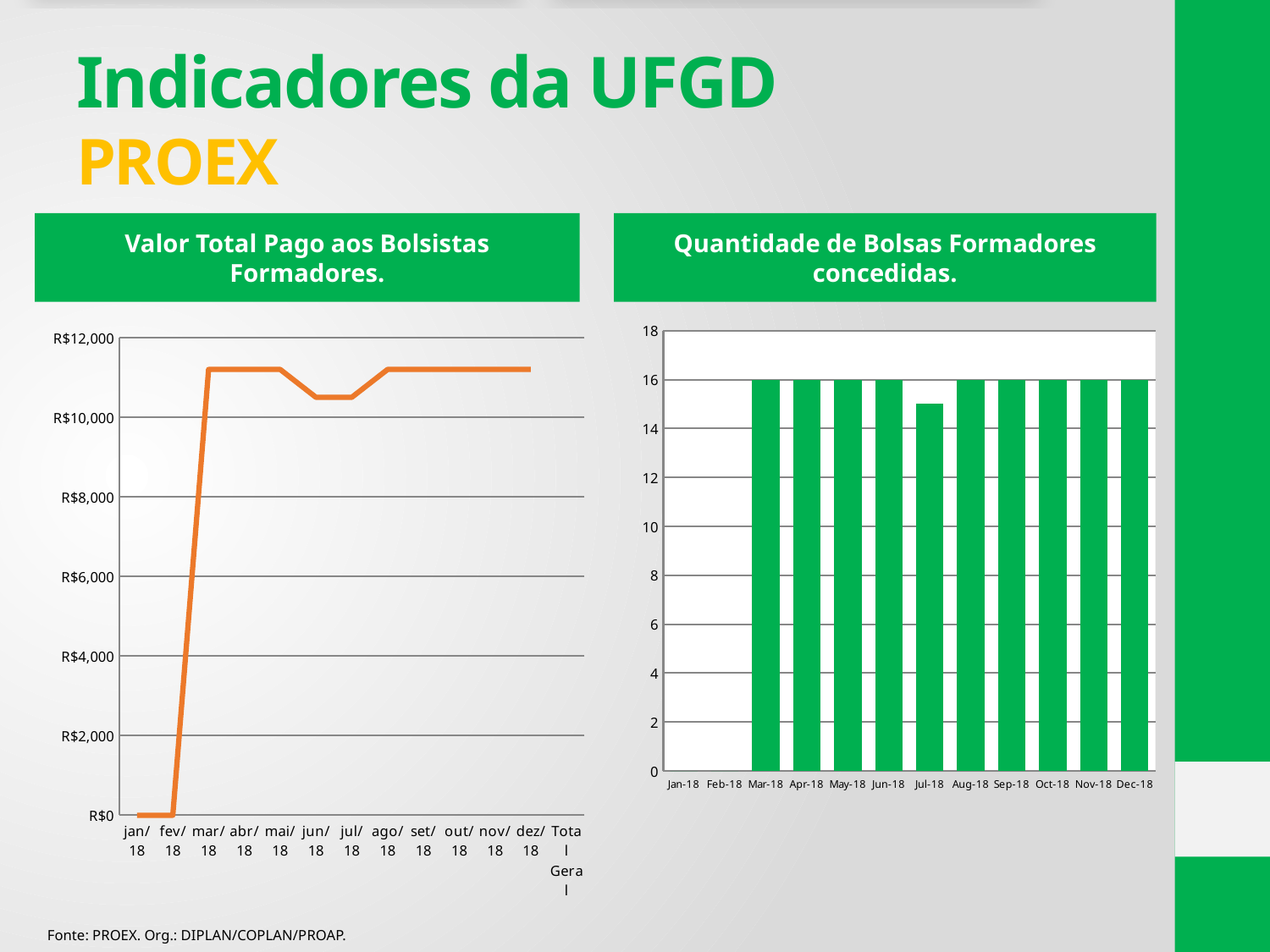
In the 'Valor Total Pago aos Bolsistas Formadores.' chart, is the value for mar/18 greater or less than R$10,000? greater What kind of chart is the 'Quantidade de Bolsas Formadores concedidas.' chart? bar chart In the 'Quantidade de Bolsas Formadores concedidas.' chart, which is larger, the value for Jun-18 or the value for Jul-18? Jun-18 How many months are shown on the x axis of the 'Quantidade de Bolsas Formadores concedidas.' chart? 12 In the 'Quantidade de Bolsas Formadores concedidas.' chart, which month from Mar-18 to Dec-18 has the lowest value? Jul-18 In the 'Valor Total Pago aos Bolsistas Formadores.' chart, which is larger, the value for mar/18 or the value for jun/18? mar/18 In the 'Valor Total Pago aos Bolsistas Formadores.' chart, does the value rise or fall from fev/18 to mar/18? rise In the 'Quantidade de Bolsas Formadores concedidas.' chart, is the value for Jul-18 greater or less than 16? less In the 'Valor Total Pago aos Bolsistas Formadores.' chart, what is the value for jan/18? R$0 What kind of chart is the 'Valor Total Pago aos Bolsistas Formadores.' chart? line chart What colour are the bars in the 'Quantidade de Bolsas Formadores concedidas.' chart? green In the 'Quantidade de Bolsas Formadores concedidas.' chart, what is the value for Mar-18? 16